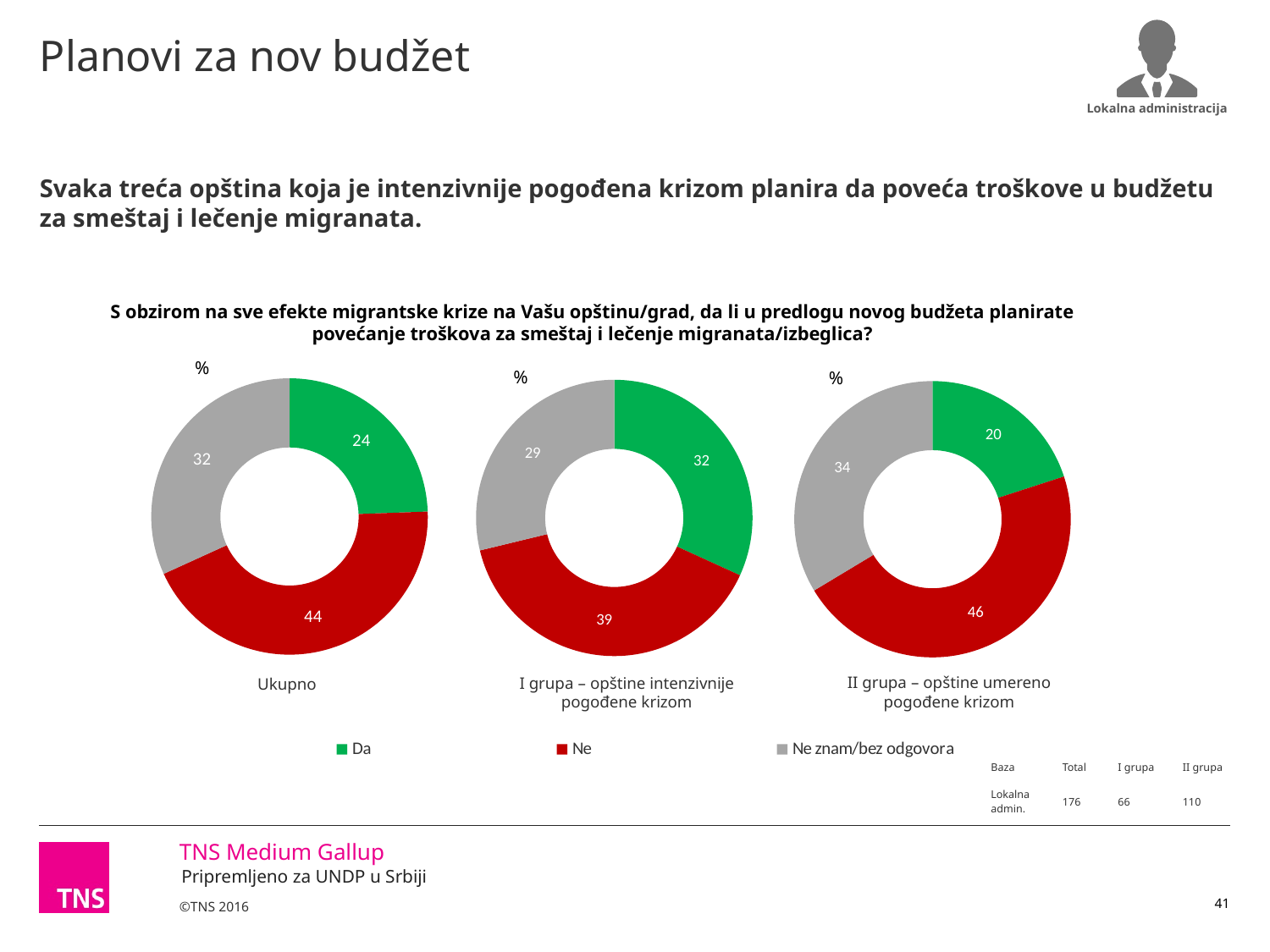
What kind of chart is used to show the 'Ukupno' data? Donut (pie) chart In the 'I grupa – opštine intenzivnije pogođene krizom' chart, is the value for 'Ne' greater or less than 30? greater In the 'Ukupno' chart, what is the value for 'Ne'? 44 In the 'II grupa – opštine umereno pogođene krizom' chart, which category has the smallest share? Da In the 'I grupa – opštine intenzivnije pogođene krizom' chart, what is the value for 'Da'? 32 How many donut charts are shown on the slide? 3 What is the difference between the 'Ne' value and the 'Da' value in the 'II grupa – opštine umereno pogođene krizom' chart? 26 In the 'II grupa – opštine umereno pogođene krizom' chart, what is the value for 'Ne znam/bez odgovora'? 34 How many entries does the legend list? 3 Is the 'Da' value larger in the 'I grupa' chart or in the 'II grupa' chart? I grupa In the 'Ukupno' chart, which category has the largest share? Ne Which colour represents 'Ne' in the charts? Red